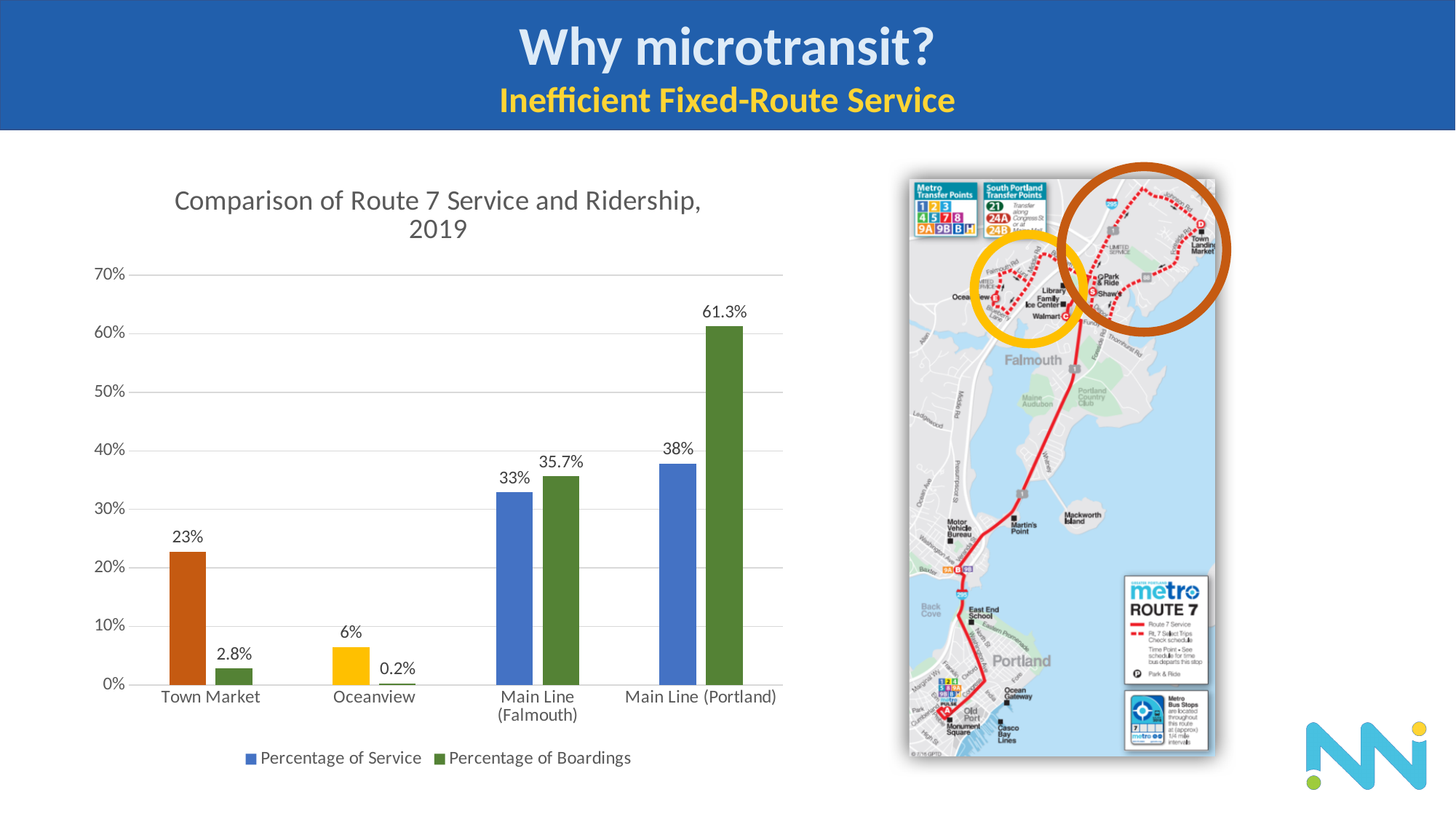
How many categories are shown on the x axis of the chart? 4 What is the Percentage of Boardings for Main Line (Portland)? 61.3% Which category has the lowest Percentage of Service? Oceanview What type of chart is shown on the slide? Bar chart Which category has the highest Percentage of Boardings? Main Line (Portland) Is the Percentage of Boardings for Main Line (Falmouth) greater or less than 30%? greater What is the difference between the Percentage of Boardings and the Percentage of Service for Main Line (Portland)? 23.3 percentage points What is the Percentage of Service for Town Market? 23% How many series does the chart legend list? 2 What is the title of the chart? Comparison of Route 7 Service and Ridership, 2019 What is the Percentage of Boardings for Oceanview? 0.2% For Town Market, which is larger: Percentage of Service or Percentage of Boardings? Percentage of Service